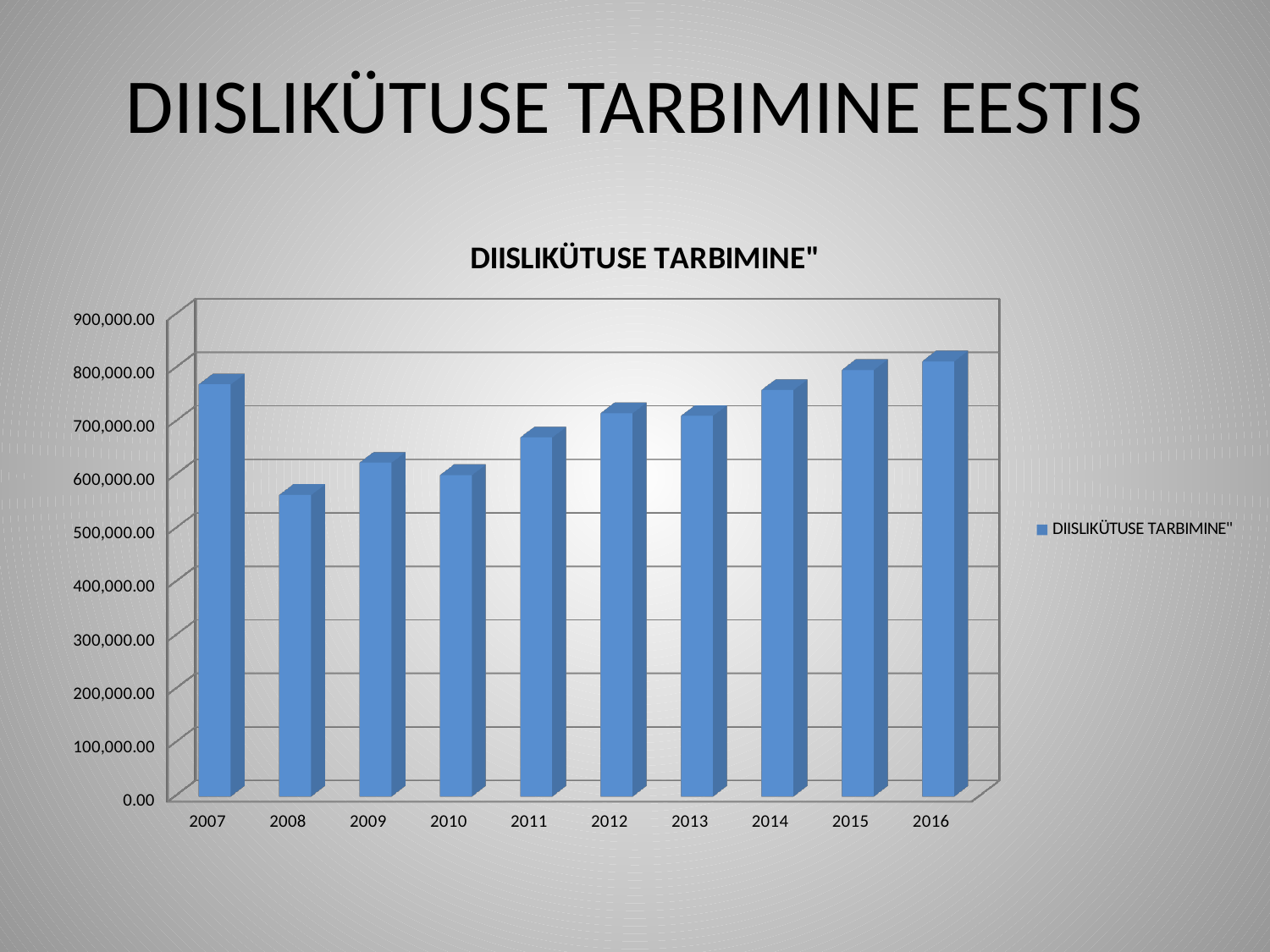
How many series does the legend list? 1 Is the value for 2008 greater or less than 600,000.00? less Which year has the larger value, 2007 or 2008? 2007 Do the values rise or fall from 2010 to 2016? rise What kind of chart is shown on the slide? bar chart Is the value for 2011 greater or less than 700,000.00? less How many years are plotted on the x axis of the chart? 10 Is the value for 2014 greater or less than 700,000.00? greater Which year has the lowest diesel fuel consumption in the chart? 2008 Which year has the highest diesel fuel consumption in the chart? 2016 What is the title of the chart? DIISLIKÜTUSE TARBIMINE"